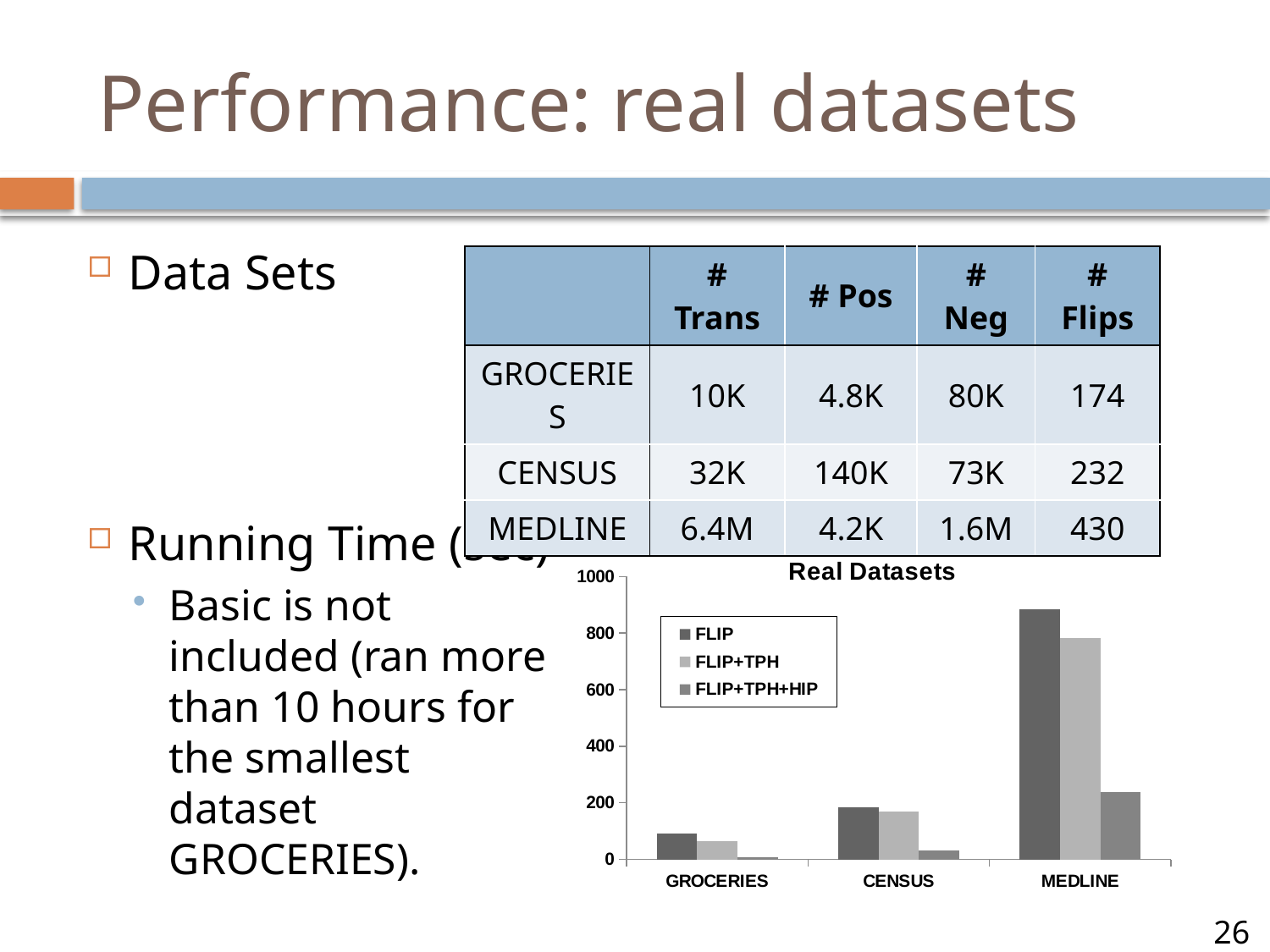
How many datasets (categories) are shown on the x axis of the "Real Datasets" chart? 3 What kind of chart is shown under the title "Real Datasets"? bar chart In the "Real Datasets" chart, which dataset has the highest FLIP running time? MEDLINE In the "Real Datasets" chart, is the FLIP+TPH value for MEDLINE greater or less than 600? greater In the "Real Datasets" chart, which is larger for MEDLINE: the FLIP value or the FLIP+TPH+HIP value? FLIP In the "Real Datasets" chart, is the FLIP value for MEDLINE greater or less than 800? greater How many series does the legend of the "Real Datasets" chart list? 3 In the "Real Datasets" chart, do the FLIP running times rise or fall going from GROCERIES to MEDLINE? rise In the "Real Datasets" chart, which dataset has the lowest FLIP+TPH+HIP running time? GROCERIES In the "Real Datasets" chart, is the FLIP value for CENSUS greater or less than 200? less What is the title of the bar chart on the slide? Real Datasets